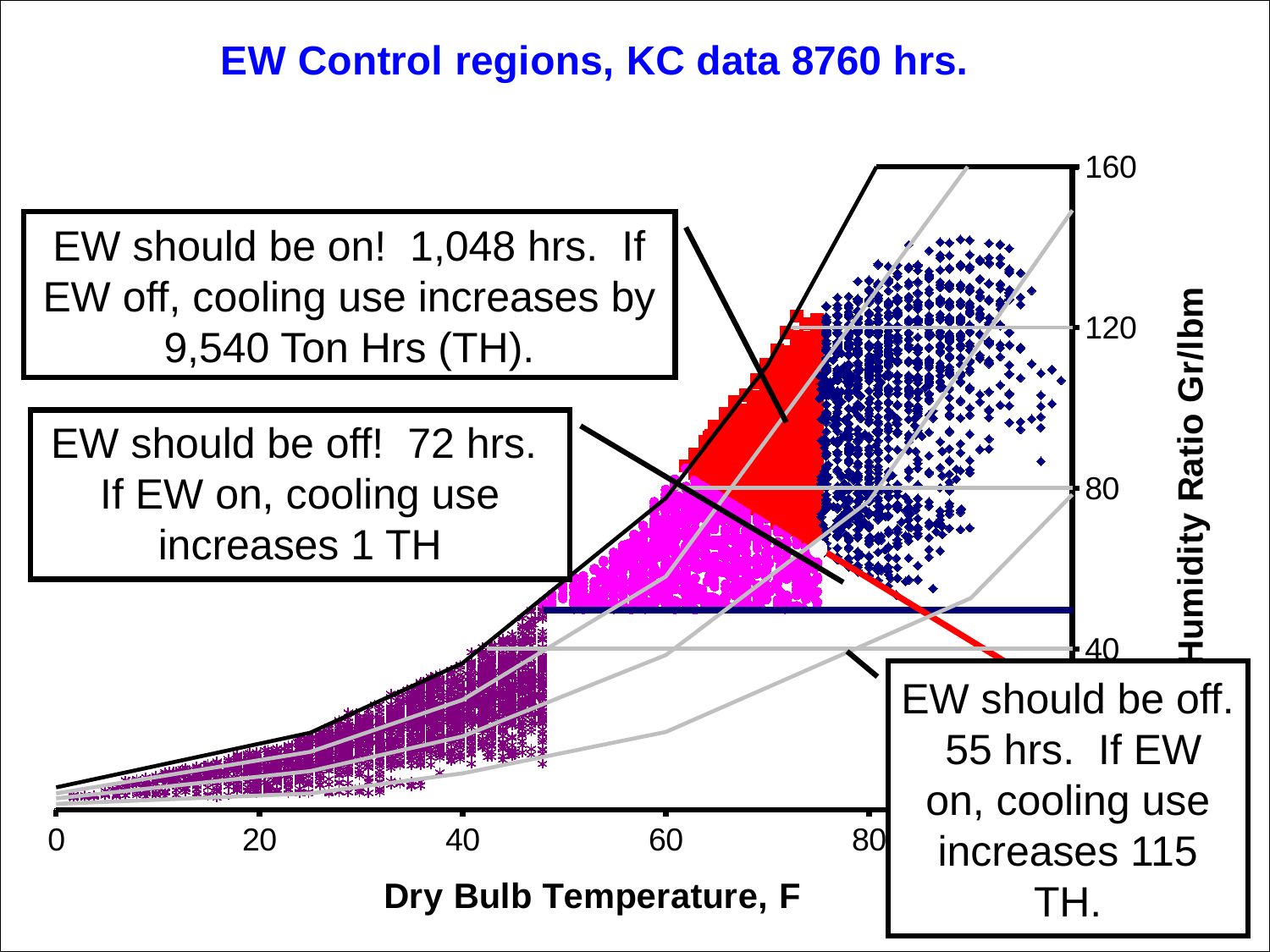
What is the label of the vertical axis? Humidity Ratio Gr/lbm Which annotated control region has the most hours? the 'EW should be on!' region (1,048 hrs.) By how much does cooling use increase if EW is off in the region where EW should be on? 9,540 Ton Hrs (TH) Which annotated control region has the fewest hours? the 'EW should be off' region with 55 hrs. What kind of chart is shown on the slide? scatter chart How many hours are in the 'EW should be off!' region where cooling use would increase by 1 TH if EW were on? 72 hrs. According to the annotation, how many hours fall in the region where EW should be on? 1,048 hrs. What is the difference in hours between the 'EW should be on' region (1,048 hrs) and the 72-hour 'EW should be off' region? 976 hrs What is the difference between the 115 TH and 1 TH cooling-use increases given for the two 'EW should be off' regions? 114 TH In the 55-hour region where EW should be off, by how much does cooling use increase if EW is on? 115 TH What is the title of the chart? EW Control regions, KC data 8760 hrs. Which annotated region has more hours: the region where EW should be on, or the 55-hour region where EW should be off? the region where EW should be on (1,048 hrs.)